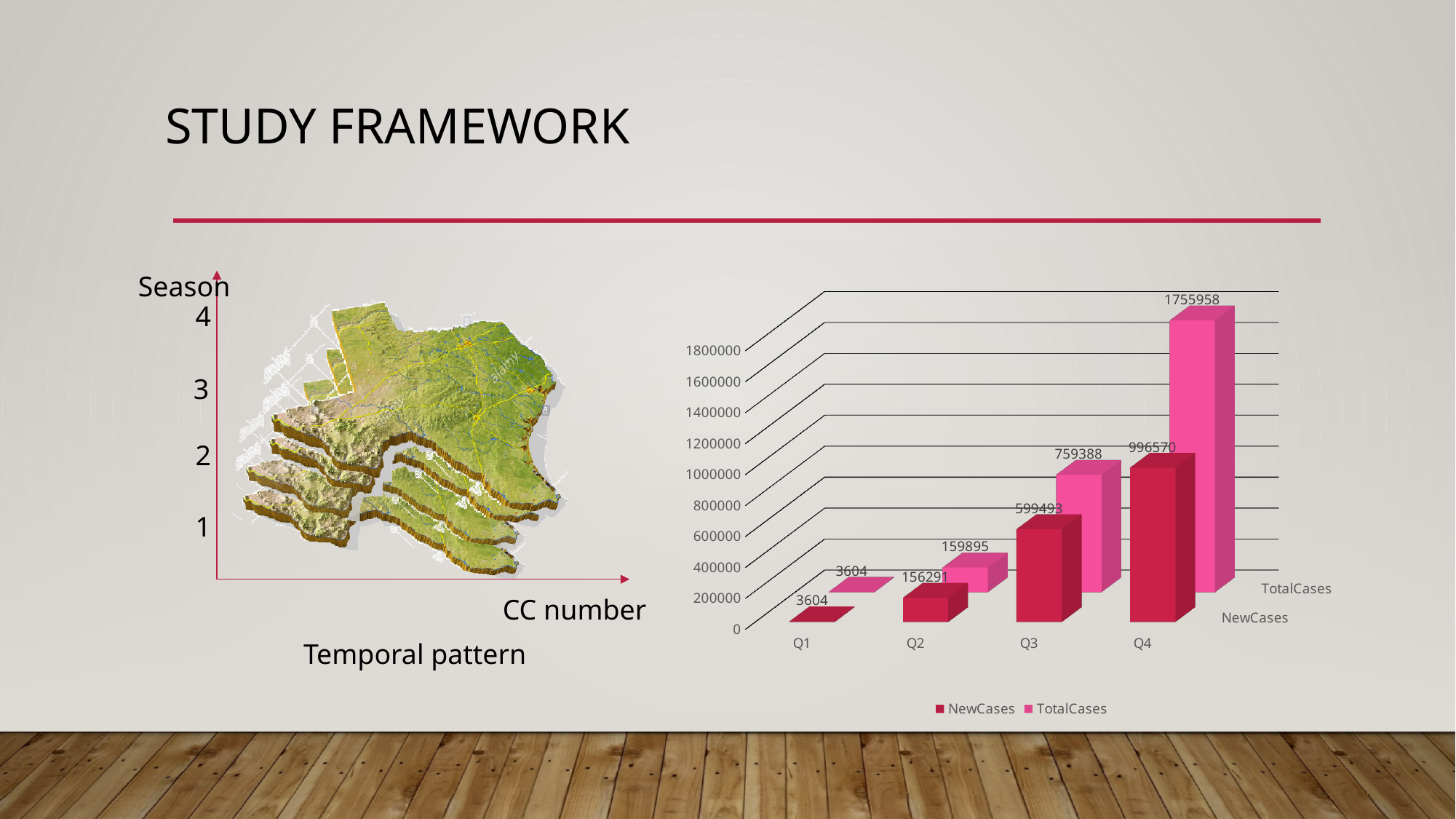
Do the NewCases values rise or fall from Q1 to Q4? Rise How many quarters are shown on the x axis of the bar chart? 4 How many series does the legend of the bar chart list? 2 Which quarter has the lowest NewCases value? Q1 What is the NewCases value for Q2? 156291 Which is larger in Q3: NewCases or TotalCases? TotalCases What is the TotalCases value for Q1? 3604 What is the difference between TotalCases and NewCases in Q4? 759388 Which quarter has the highest TotalCases value? Q4 What kind of chart is shown on the right side of the slide? Bar chart What is the TotalCases value for Q4? 1755958 What is the NewCases value for Q3? 599493